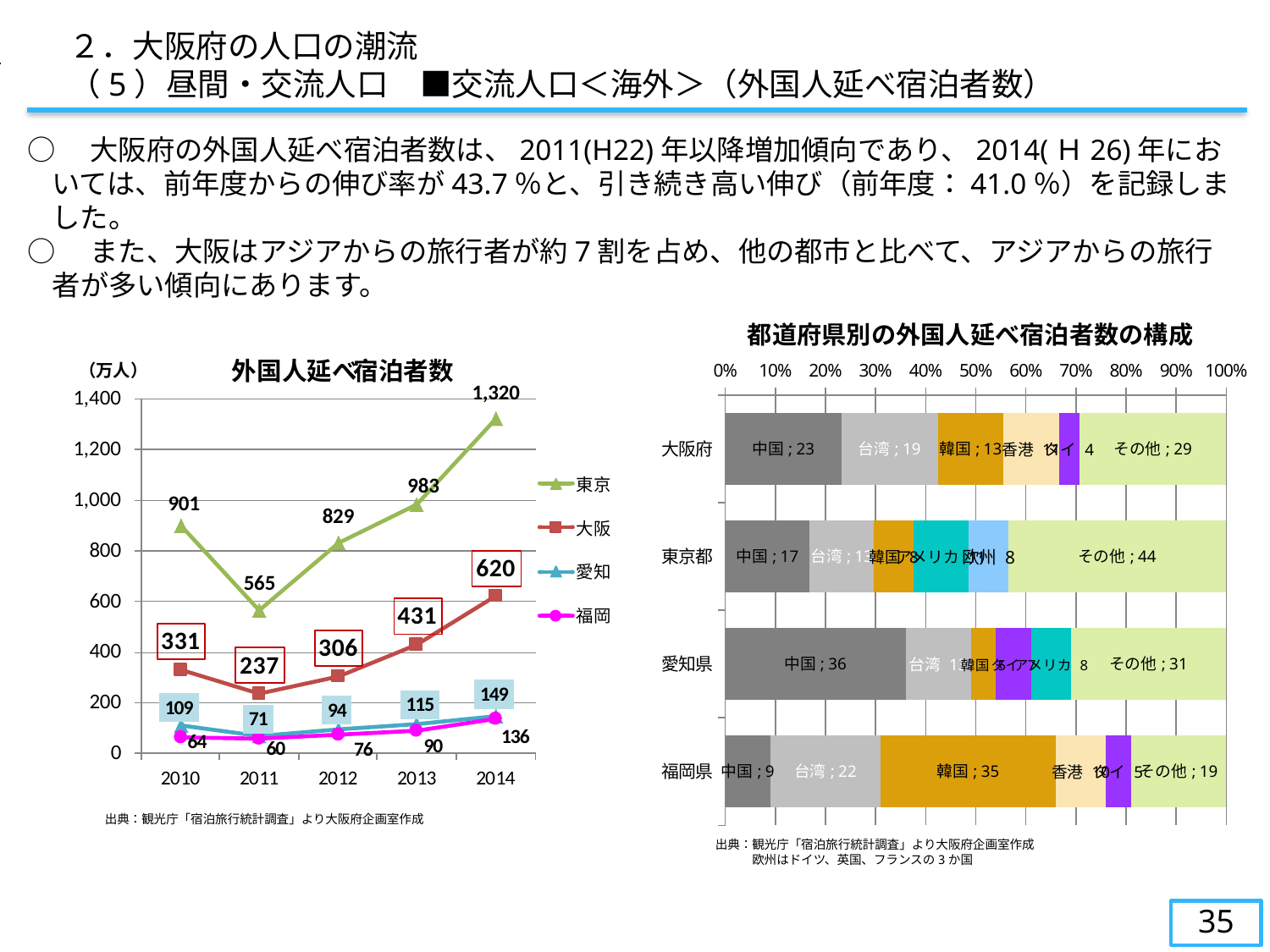
In the line chart 外国人延べ宿泊者数, in which year is the value for 大阪 lowest? 2011 In the line chart 外国人延べ宿泊者数, what is the difference between the 大阪 values for 2014 and 2013? 189 In the chart 都道府県別の外国人延べ宿泊者数の構成, what is the value for 中国 in the 愛知県 bar? 36 In the line chart 外国人延べ宿泊者数, what is the value for 東京 in 2010? 901 In the line chart 外国人延べ宿泊者数, what is the value for 大阪 in 2014? 620 What kind of chart is 外国人延べ宿泊者数 on the left of the slide? line chart In the line chart 外国人延べ宿泊者数, in which year is the value for 東京 highest? 2014 In the line chart 外国人延べ宿泊者数, how many years are shown on the x axis? 5 In the line chart 外国人延べ宿泊者数, does the value for 東京 rise or fall from 2011 to 2014? rise In the line chart 外国人延べ宿泊者数, how many series does the legend list? 4 In the chart 都道府県別の外国人延べ宿泊者数の構成, what is the value for 韓国 in the 福岡県 bar? 35 In the line chart 外国人延べ宿泊者数, which series has the larger value in 2014, 愛知 or 福岡? 愛知